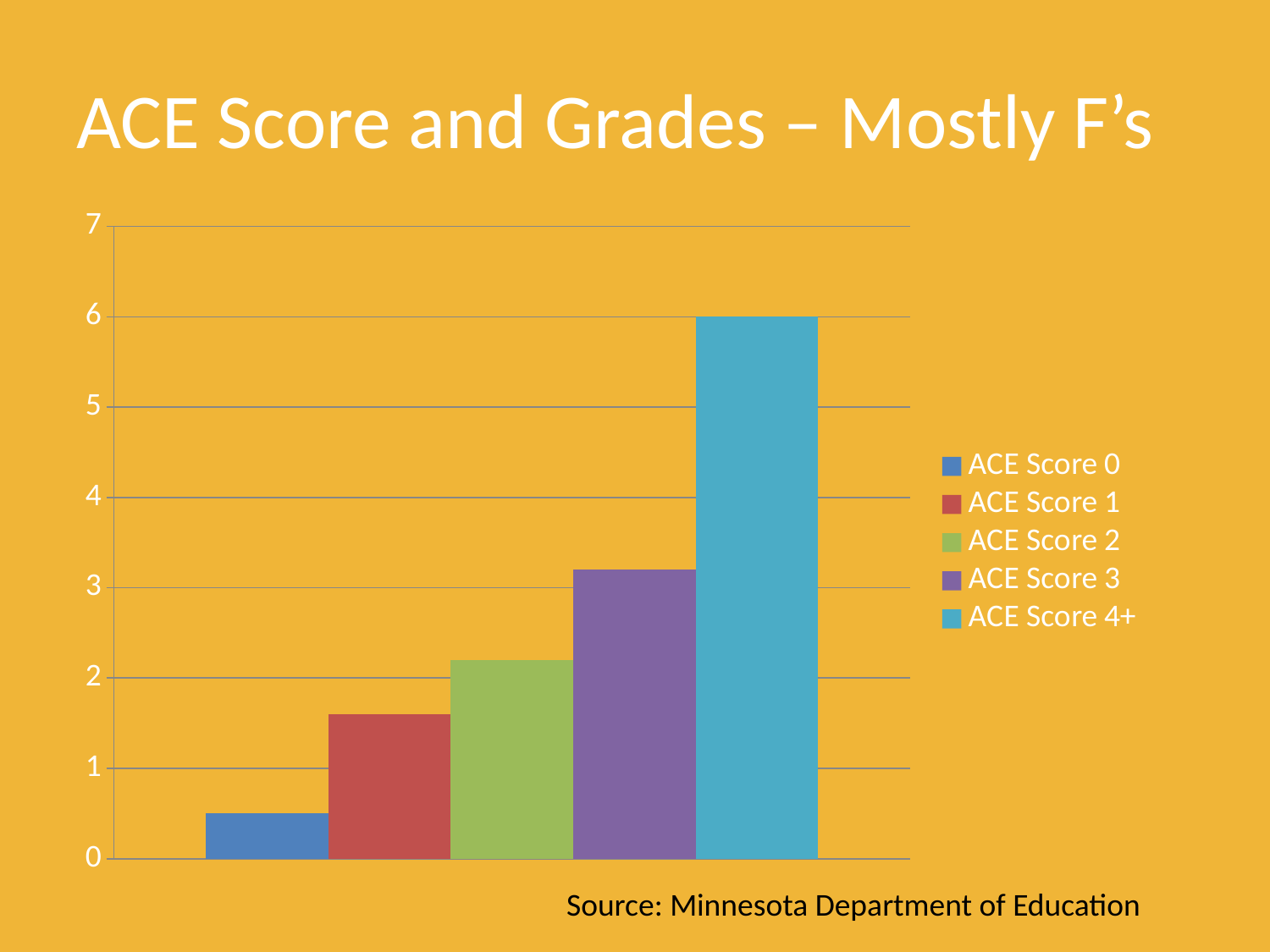
What is the value for ACE Score 4+? 6 Which ACE Score group has the lowest bar? ACE Score 0 What is the title of the chart on the slide? ACE Score and Grades – Mostly F's Which is larger, the value for ACE Score 1 or the value for ACE Score 3? ACE Score 3 Do the bar values rise or fall as the ACE Score increases from 0 to 4+? rise Which ACE Score group has the highest bar? ACE Score 4+ What kind of chart is shown on the slide? bar chart How many series does the legend list? 5 Is the value for ACE Score 0 greater or less than 1? less Is the value for ACE Score 2 greater or less than 2? greater Is the value for ACE Score 3 greater or less than 3? greater